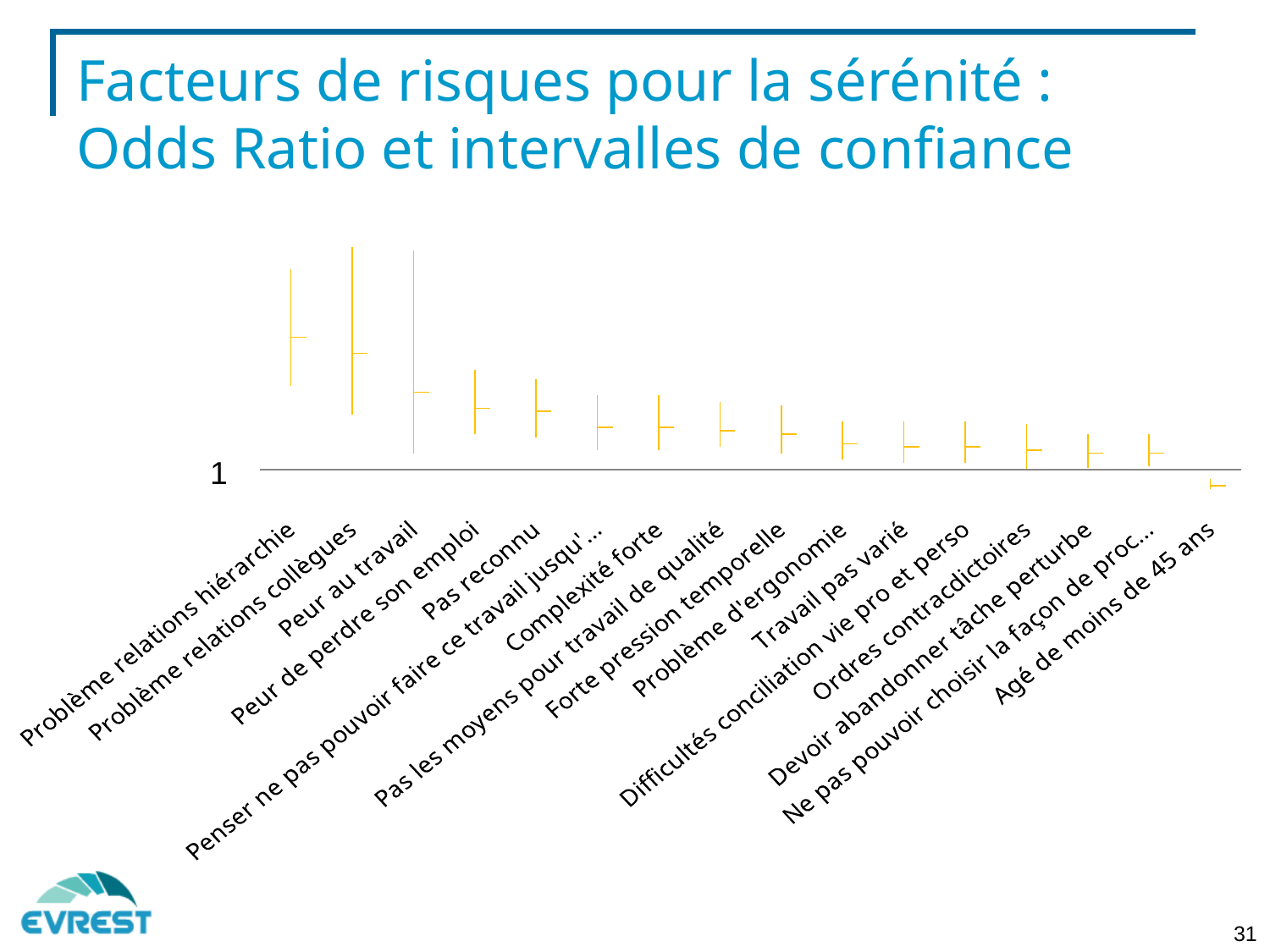
Which category has the lowest odds ratio in the chart? Agé de moins de 45 ans Which has the larger odds ratio, 'Pas reconnu' or 'Travail pas varié'? Pas reconnu Is the odds ratio for 'Problème relations hiérarchie' greater or less than 1? greater Which has the larger odds ratio, 'Problème relations hiérarchie' or 'Agé de moins de 45 ans'? Problème relations hiérarchie Which category is plotted first (leftmost) on the x axis? Problème relations hiérarchie Is the odds ratio for 'Agé de moins de 45 ans' greater or less than 1? less Is the odds ratio for 'Complexité forte' greater or less than 1? greater What is the title of the chart on the slide? Facteurs de risques pour la sérénité : Odds Ratio et intervalles de confiance How many risk factors (categories) are plotted along the x axis of the chart? 16 Do the odds ratios generally rise or fall moving from left to right along the x axis? fall Which has the larger odds ratio, 'Peur au travail' or 'Ordres contradictoires'? Peur au travail What is the only value labelled on the vertical axis of the chart? 1